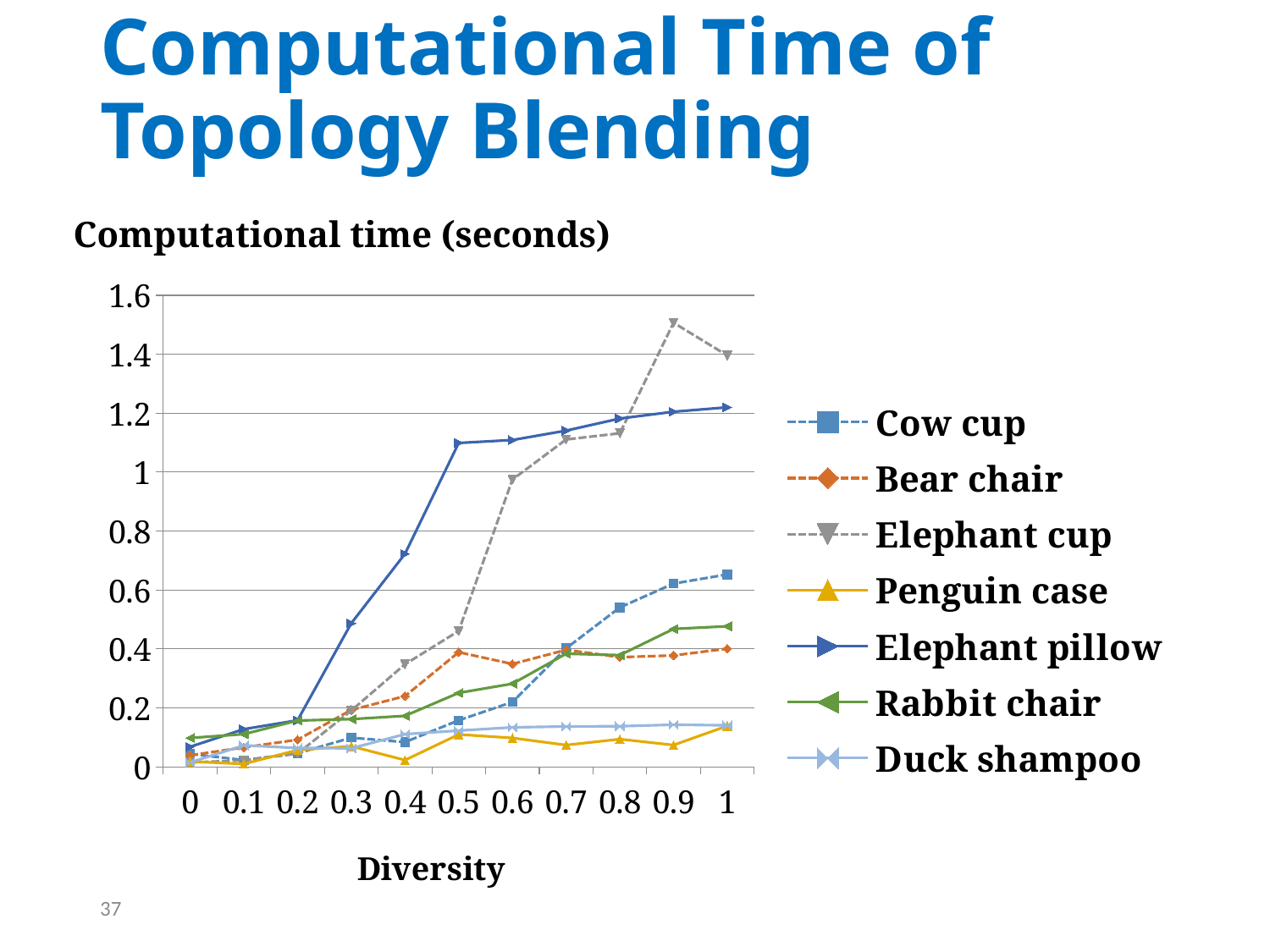
At diversity 0.8, which is larger: Cow cup or Rabbit chair? Cow cup Is the value for Cow cup at diversity 1 greater or less than 0.8? less Which series has the highest computational time at diversity 1? Elephant cup At diversity 0.4, which is larger: Elephant pillow or Elephant cup? Elephant pillow What kind of chart is shown on the slide? line chart What is the label of the x axis? Diversity How many diversity values are marked along the x axis? 11 How many series does the legend list? 7 Is the value for Elephant cup at diversity 0.9 greater or less than 1.4? greater Does the Elephant pillow series rise or fall as diversity increases from 0 to 1? rise Is the value for Elephant pillow at diversity 0.5 greater or less than 1? greater Which series has the lowest computational time at diversity 0.9? Penguin case